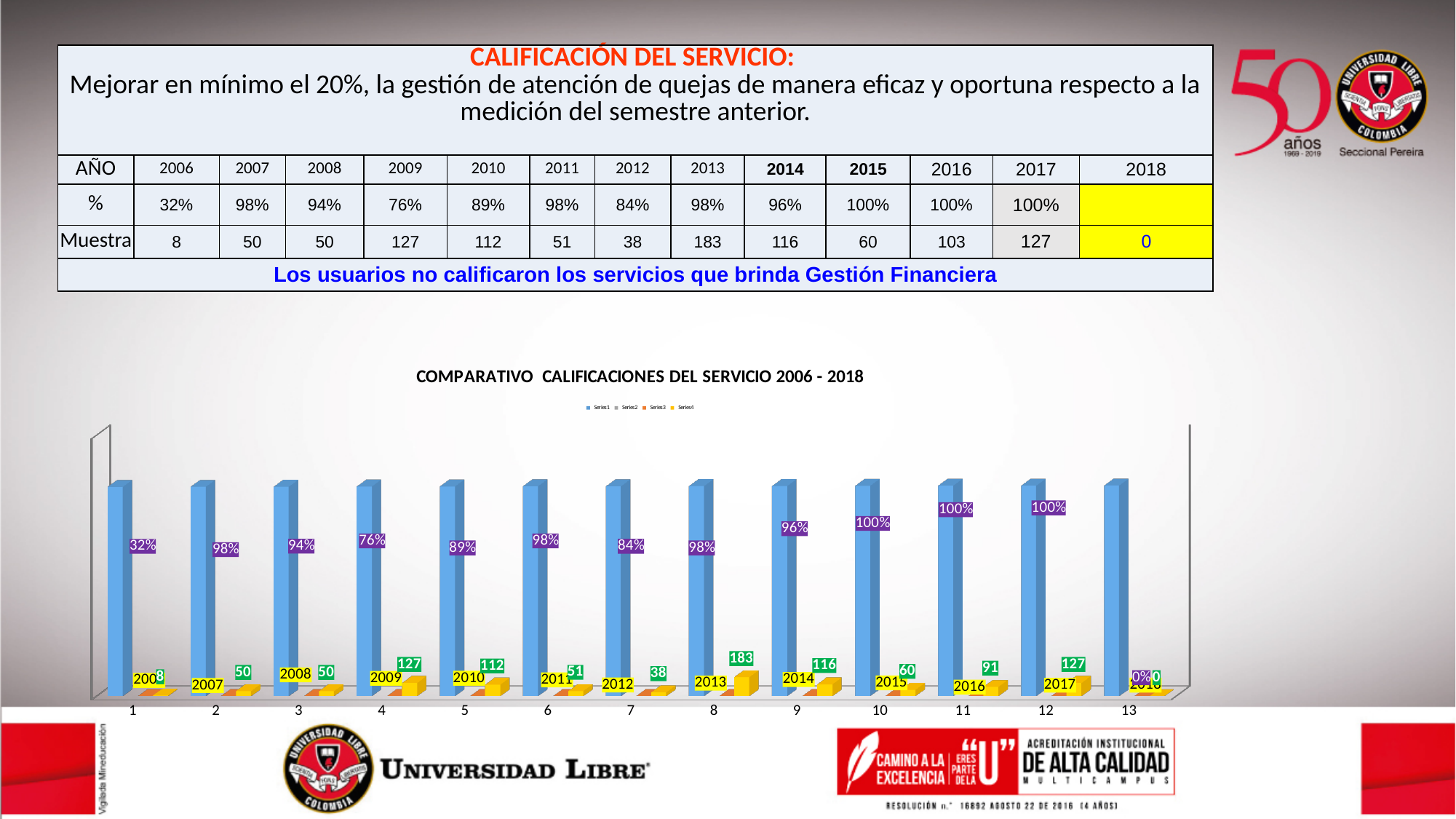
What sample size (muestra) value is labelled for 2013 in the chart? 183 What sample size value is labelled for 2016 in the chart? 91 Which year has the highest sample size label in the chart? 2013 What percentage is labelled for 2006 in the chart? 32% Which has the larger sample size label in the chart, 2009 or 2010? 2009 What is the title of the chart? COMPARATIVO CALIFICACIONES DEL SERVICIO 2006 - 2018 How many categories are shown along the x axis of the chart? 13 How many series does the chart legend list? 4 What kind of chart is shown on the slide? bar chart Which year has the lowest percentage label in the chart, excluding 2018? 2006 What is the difference between the sample size labels for 2013 and 2012 in the chart? 145 What percentage is labelled for 2009 in the chart? 76%